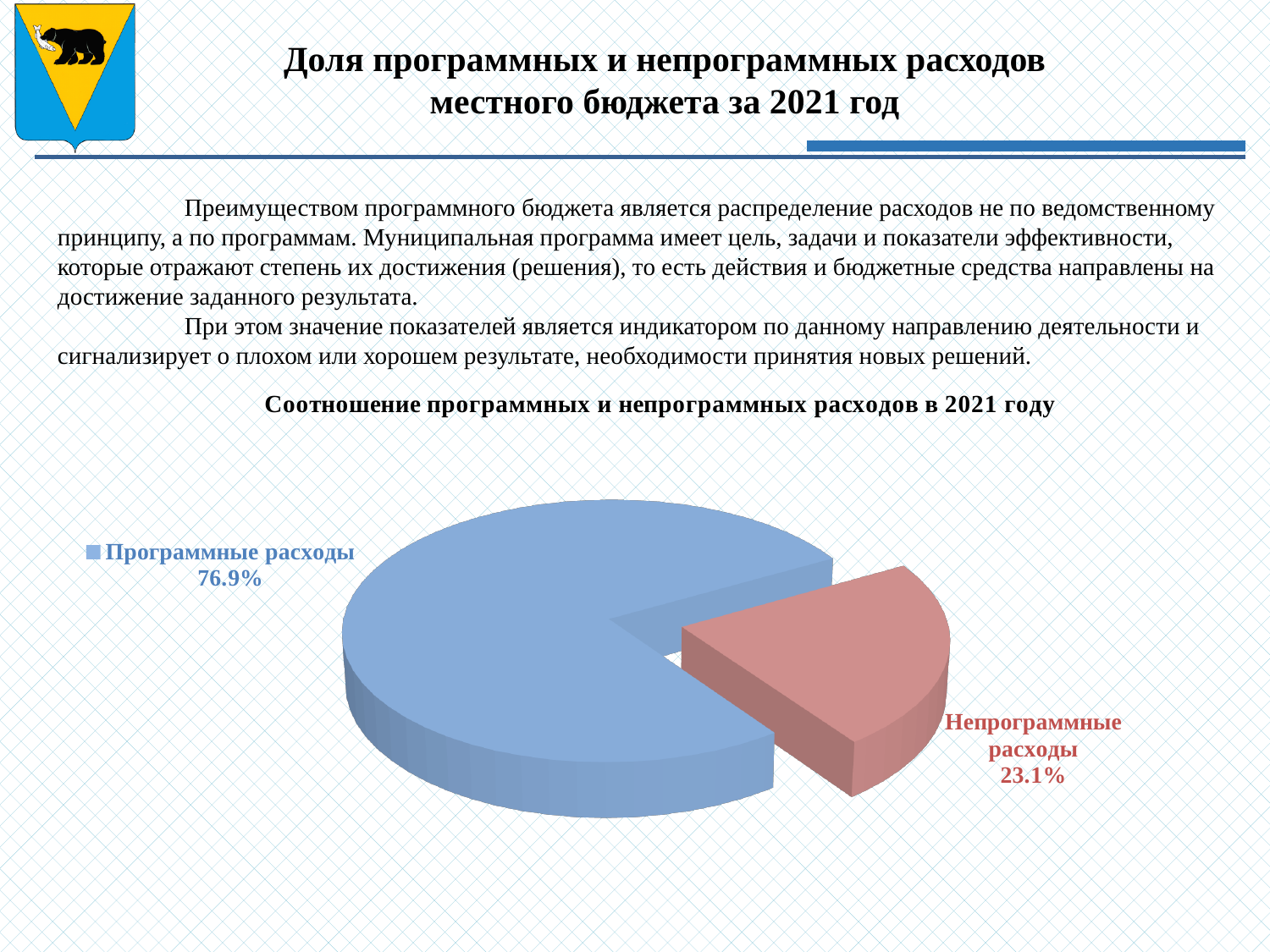
Which category has the smallest slice of the pie? Непрограммные расходы What is the difference in percentage points between Программные расходы and Непрограммные расходы? 53.8 What is the title of the chart? Соотношение программных и непрограммных расходов в 2021 году What share of the pie is labelled for Непрограммные расходы? 23.1% What share of the pie is labelled for Программные расходы? 76.9% Is the share for Программные расходы greater or less than 75%? greater What kind of chart is shown on the slide? Pie chart Is the share for Непрограммные расходы greater or less than 25%? less What colour is the slice for Непрограммные расходы? Red (pink) Which is larger: the share for Программные расходы or for Непрограммные расходы? Программные расходы Which category has the largest slice of the pie? Программные расходы How many slices does the pie chart have? 2